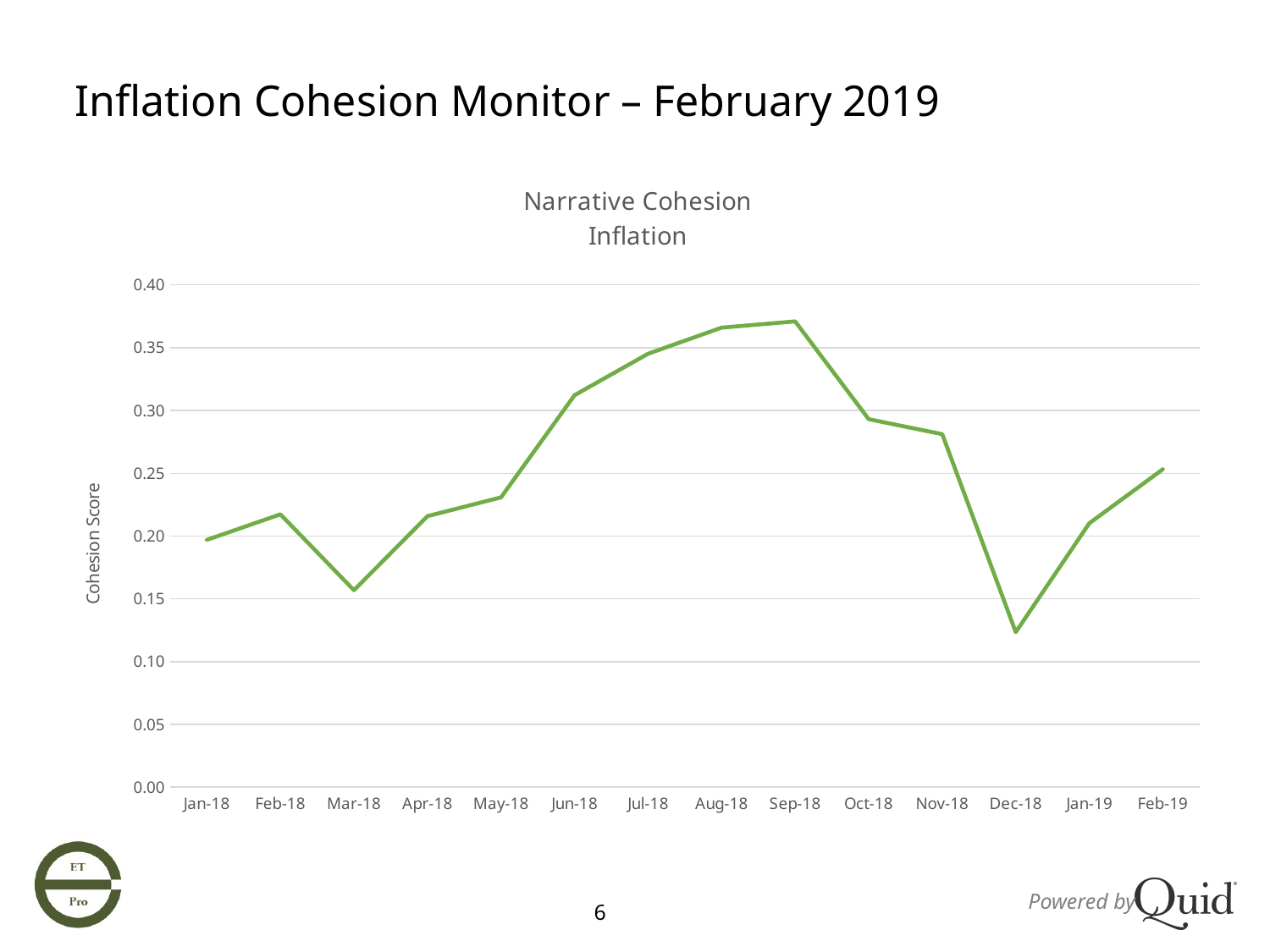
Which has a higher cohesion score, Jan-19 or Feb-19? Feb-19 Is the value for Jun-18 greater or less than 0.30? greater Which month has the highest cohesion score? Sep-18 What is the label on the y axis? Cohesion Score Is the value for Sep-18 greater or less than 0.35? greater What kind of chart is shown on the slide? line chart Is the value for Dec-18 greater or less than 0.15? less Which month has the lowest cohesion score? Dec-18 How many months are plotted on the x axis? 14 Does the cohesion score rise or fall from Sep-18 to Dec-18? fall Which has a higher cohesion score, Jun-18 or Mar-18? Jun-18